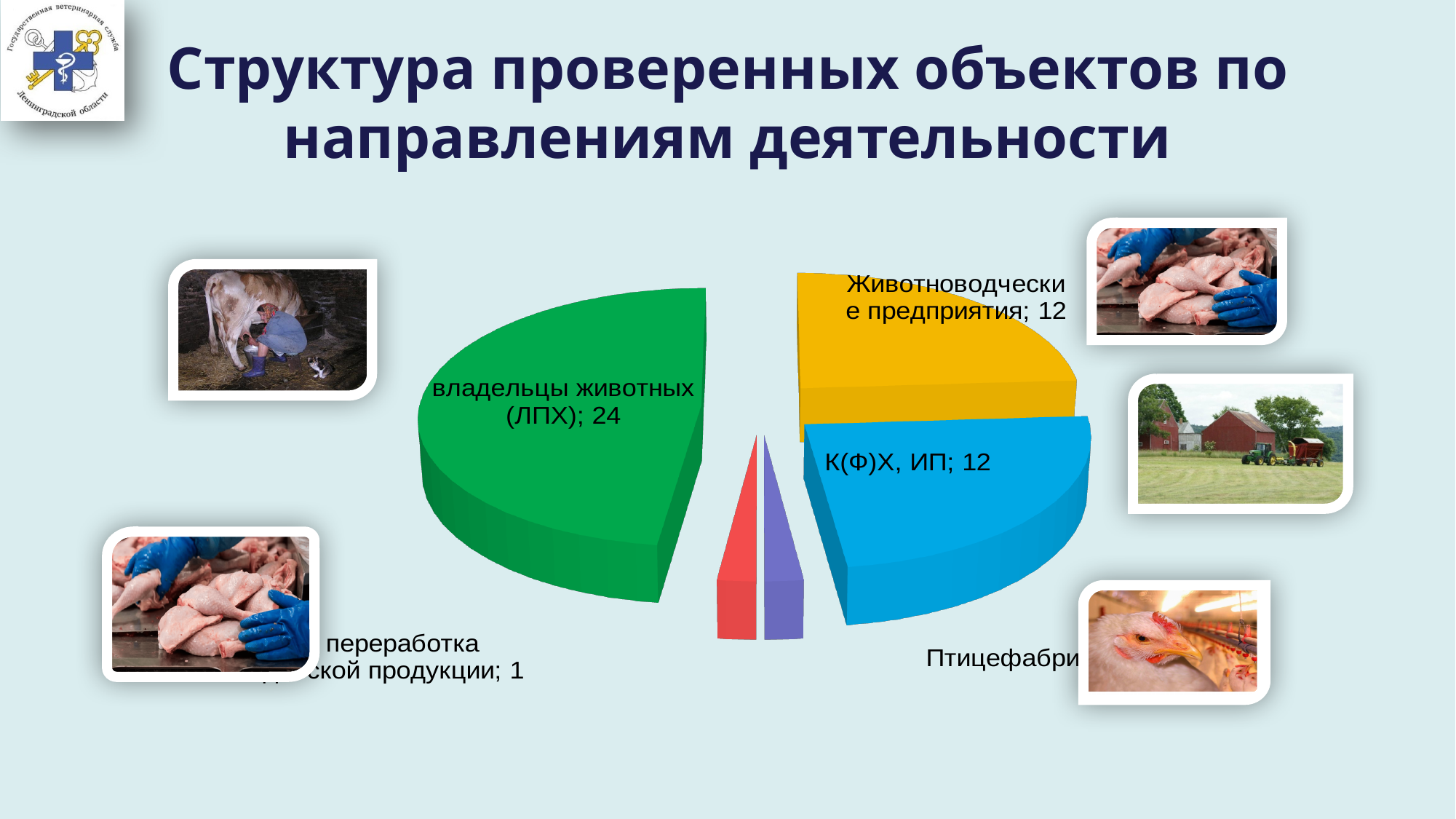
What is the difference between the values for владельцы животных (ЛПХ) and К(Ф)Х, ИП? 12 What value is shown for владельцы животных (ЛПХ)? 24 What value is shown for the red slice of the pie? 1 What kind of chart is shown on the slide? pie chart What colour is the slice for К(Ф)Х, ИП? blue Which category has the largest slice of the pie? владельцы животных (ЛПХ) What value is shown for К(Ф)Х, ИП? 12 How many slices does the pie chart have? 5 What value is shown for Животноводческие предприятия? 12 Which is larger: the value for владельцы животных (ЛПХ) or the value for Животноводческие предприятия? владельцы животных (ЛПХ) What colour is the slice for владельцы животных (ЛПХ)? green